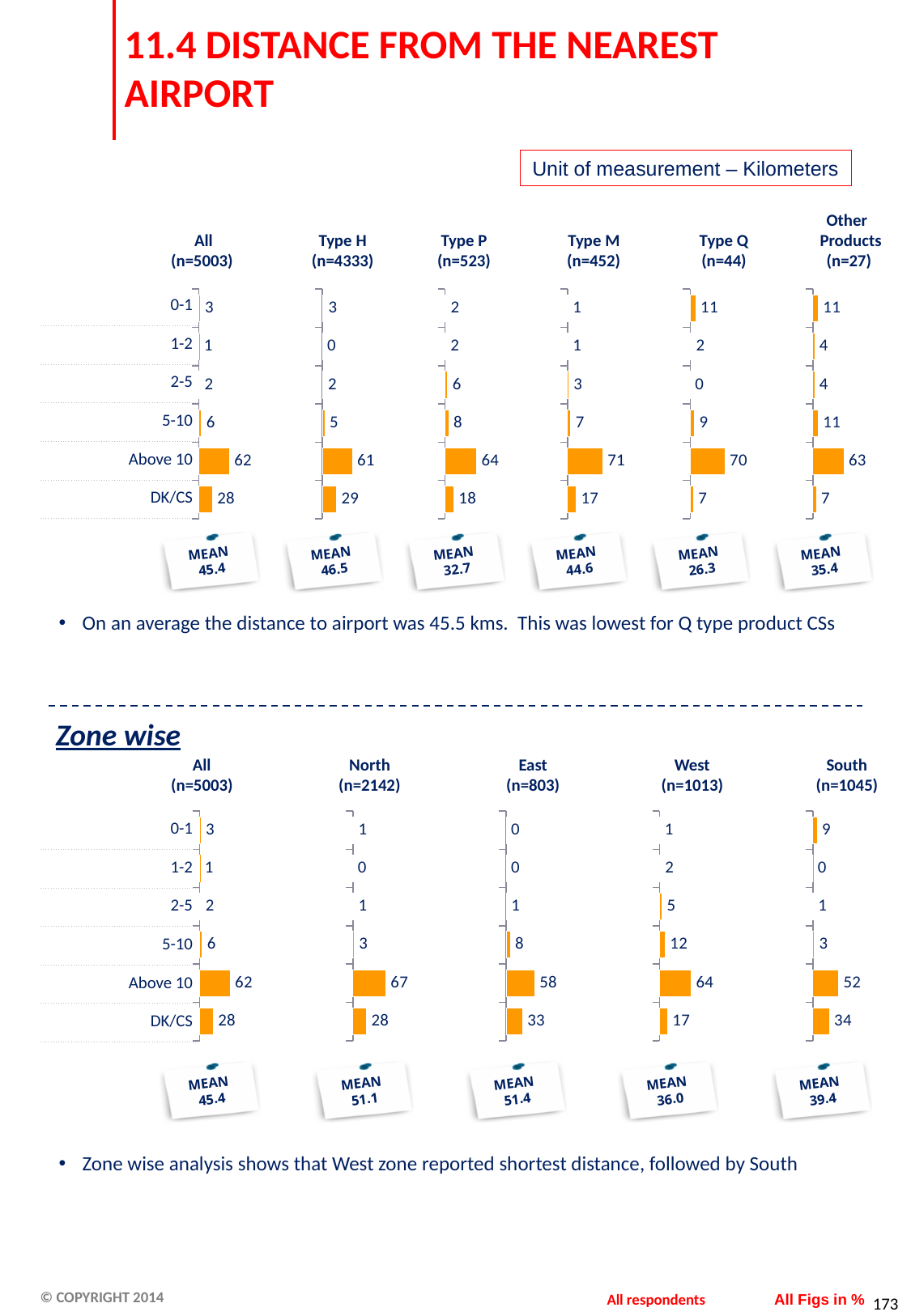
In the top section, what is the difference between the 'Above 10' values for Type P (n=523) and Type H (n=4333)? 3 In the Zone wise section, what is the difference between the 'DK/CS' values for South (n=1045) and West (n=1013)? 17 How many distance categories are shown in each chart on the slide? 6 In the Zone wise section, what is the value for '5-10' in the West (n=1013) chart? 12 In the top section, what is the value for 'DK/CS' in the Type H (n=4333) chart? 29 In the Zone wise section, what is the value for 'Above 10' in the North (n=2142) chart? 67 In the top section, which category has the highest value in the Type Q (n=44) chart? Above 10 In the top section, what is the value for 'Above 10' in the Type M (n=452) chart? 71 In the Zone wise section, which zone chart has the lowest 'Above 10' value? South (n=1045) What unit of measurement is stated for the charts on the slide? Kilometers What kind of chart is used on this slide? Bar chart In the top section, which is larger: the 'DK/CS' value for All (n=5003) or for Type P (n=523)? All (n=5003)